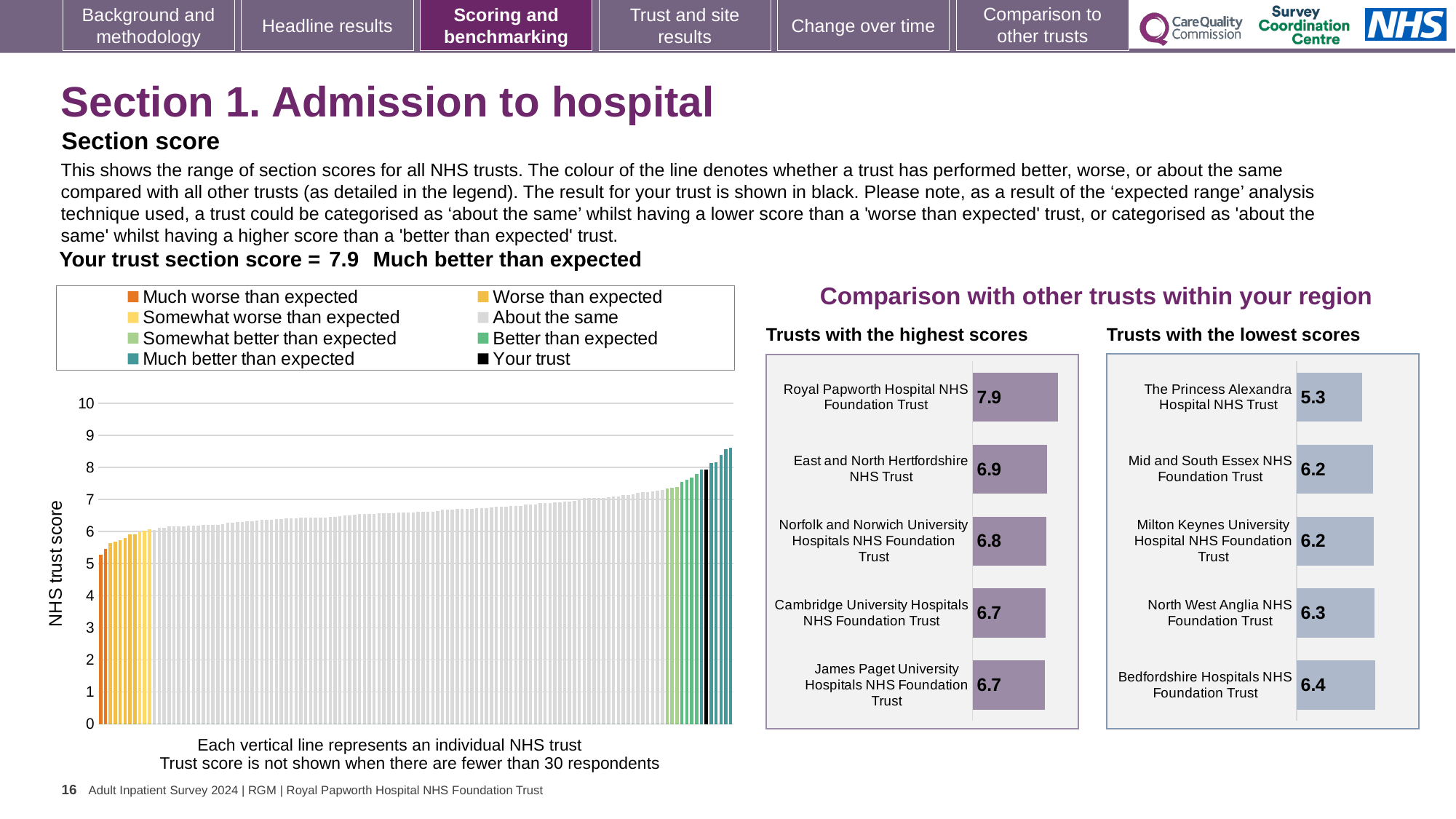
In the 'Trusts with the lowest scores' chart, what is the score for Bedfordshire Hospitals NHS Foundation Trust? 6.4 In the large chart on the left, is the value of the leftmost (lowest) bar greater or less than 6? less In the 'Trusts with the highest scores' chart, which trust has the highest score? Royal Papworth Hospital NHS Foundation Trust In the large chart on the left, do the trust scores rise or fall from left to right? rise In the 'Trusts with the lowest scores' chart, what is the score for The Princess Alexandra Hospital NHS Trust? 5.3 In the 'Trusts with the lowest scores' chart, which trust has the lowest score? The Princess Alexandra Hospital NHS Trust In the 'Trusts with the lowest scores' chart, which has the larger score: North West Anglia NHS Foundation Trust or Mid and South Essex NHS Foundation Trust? North West Anglia NHS Foundation Trust How many trusts are shown in the 'Trusts with the lowest scores' chart? 5 In the 'Trusts with the highest scores' chart, what is the score for Royal Papworth Hospital NHS Foundation Trust? 7.9 In the 'Trusts with the highest scores' chart, what is the difference between the scores of Royal Papworth Hospital NHS Foundation Trust and East and North Hertfordshire NHS Trust? 1.0 In the 'Trusts with the highest scores' chart, what is the score for Norfolk and Norwich University Hospitals NHS Foundation Trust? 6.8 How many entries does the legend of the large chart on the left list? 8